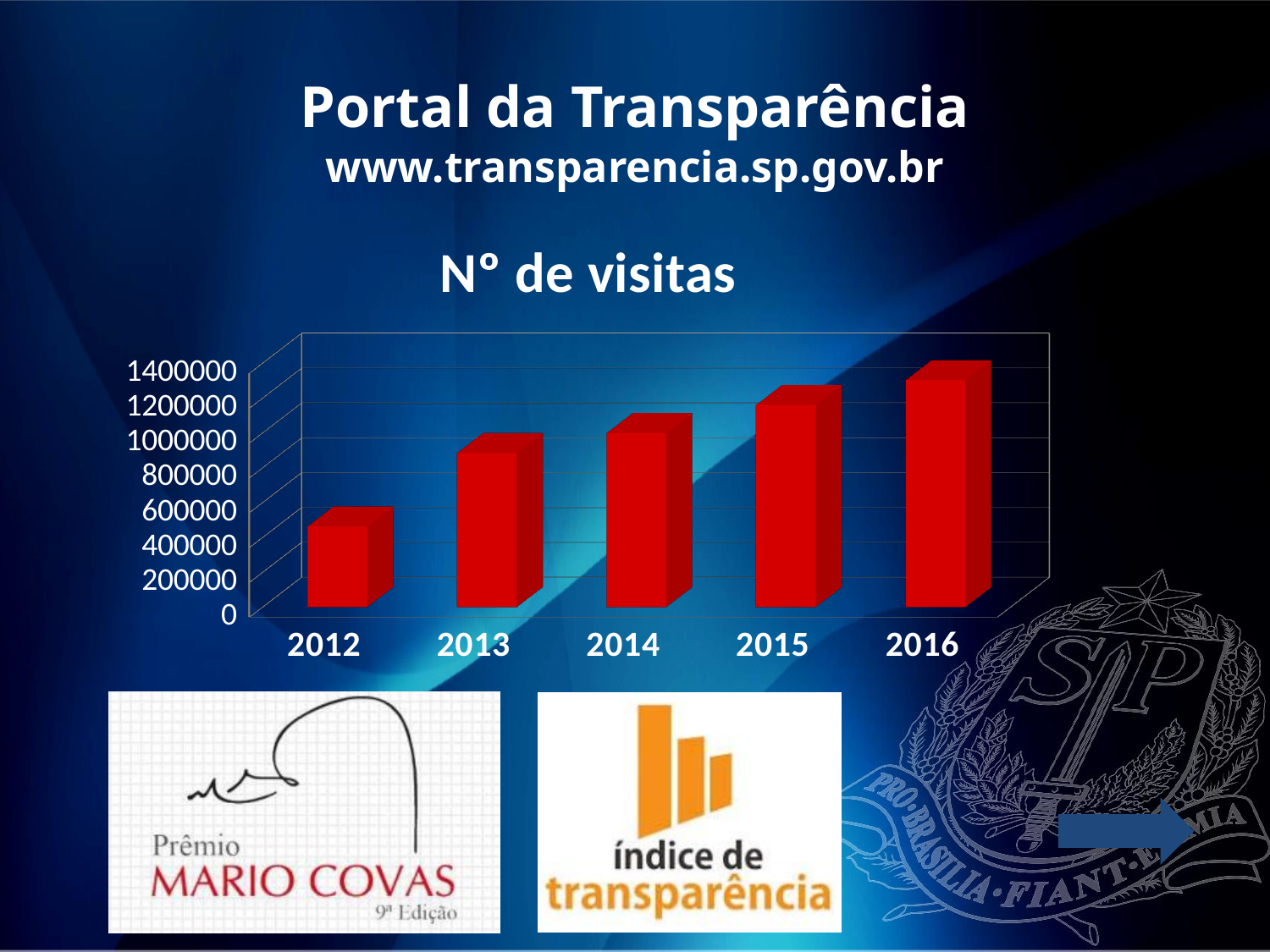
What kind of chart is shown on the slide? bar chart Which year has the highest number of visits? 2016 What is the title of the chart? Nº de visitas Is the value for 2014 greater or less than 1200000? less Is the value for 2012 greater or less than 800000? less Is the value for 2016 greater or less than 1200000? greater Which year has the lowest number of visits? 2012 How many years are shown on the x axis of the chart? 5 Do the values rise or fall from 2012 to 2016? rise Which year has more visits, 2012 or 2013? 2013 What colour are the bars in the chart? red